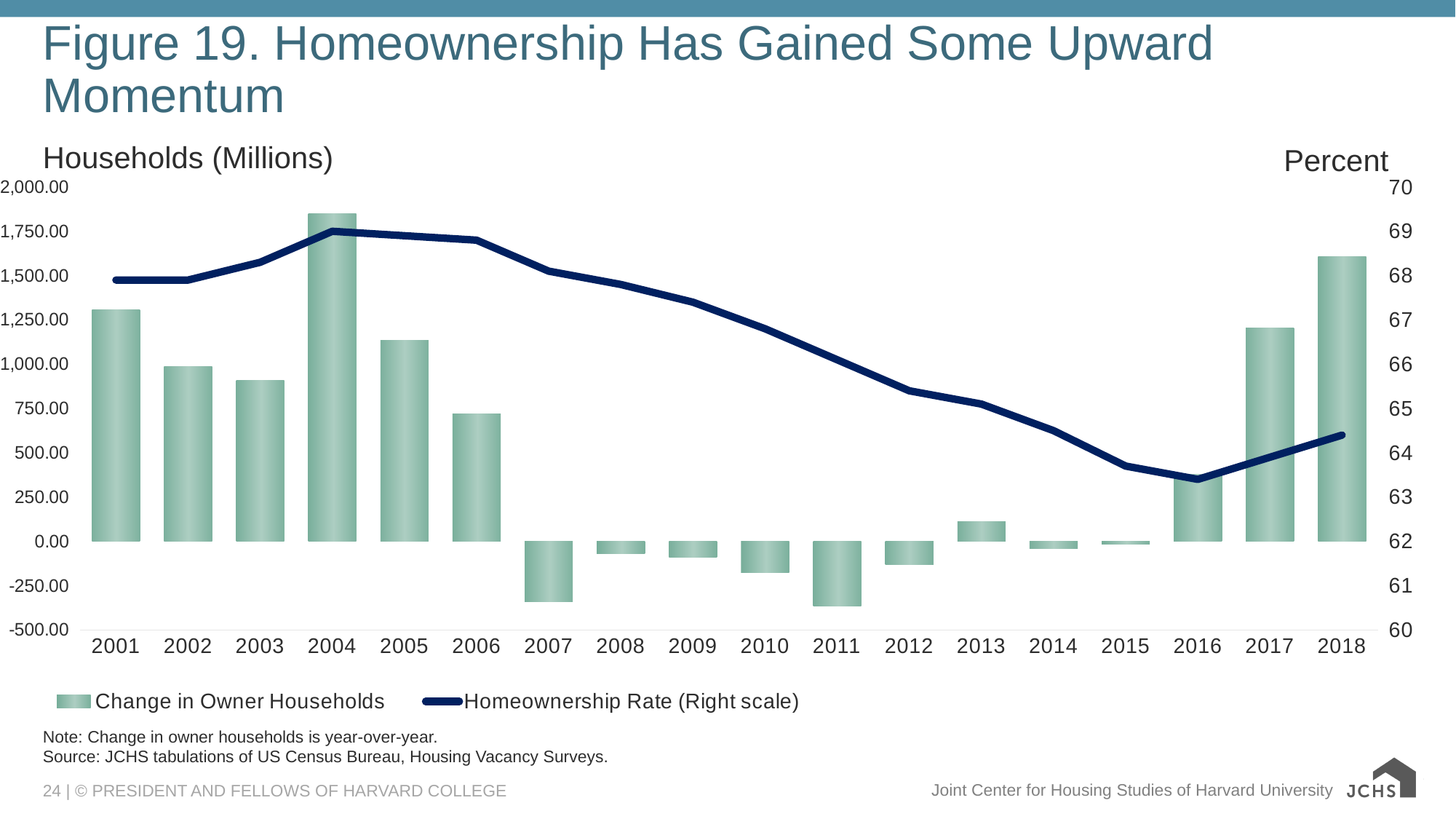
In which year is the Change in Owner Households bar the highest? 2004 Does the Homeownership Rate line rise or fall between 2004 and 2016? fall What kind of chart is shown on the slide? A combination bar and line chart What is the label of the left vertical axis? Households (Millions) Is the Change in Owner Households value for 2004 greater or less than 1,750.00? greater Is the Homeownership Rate for 2016 greater or less than 64? less Is the Change in Owner Households value for 2007 greater or less than 0.00? less In which year does the Homeownership Rate line reach its lowest point? 2016 How many series does the legend list? 2 How many years are shown on the x axis? 18 Which year has the larger Change in Owner Households bar, 2004 or 2018? 2004